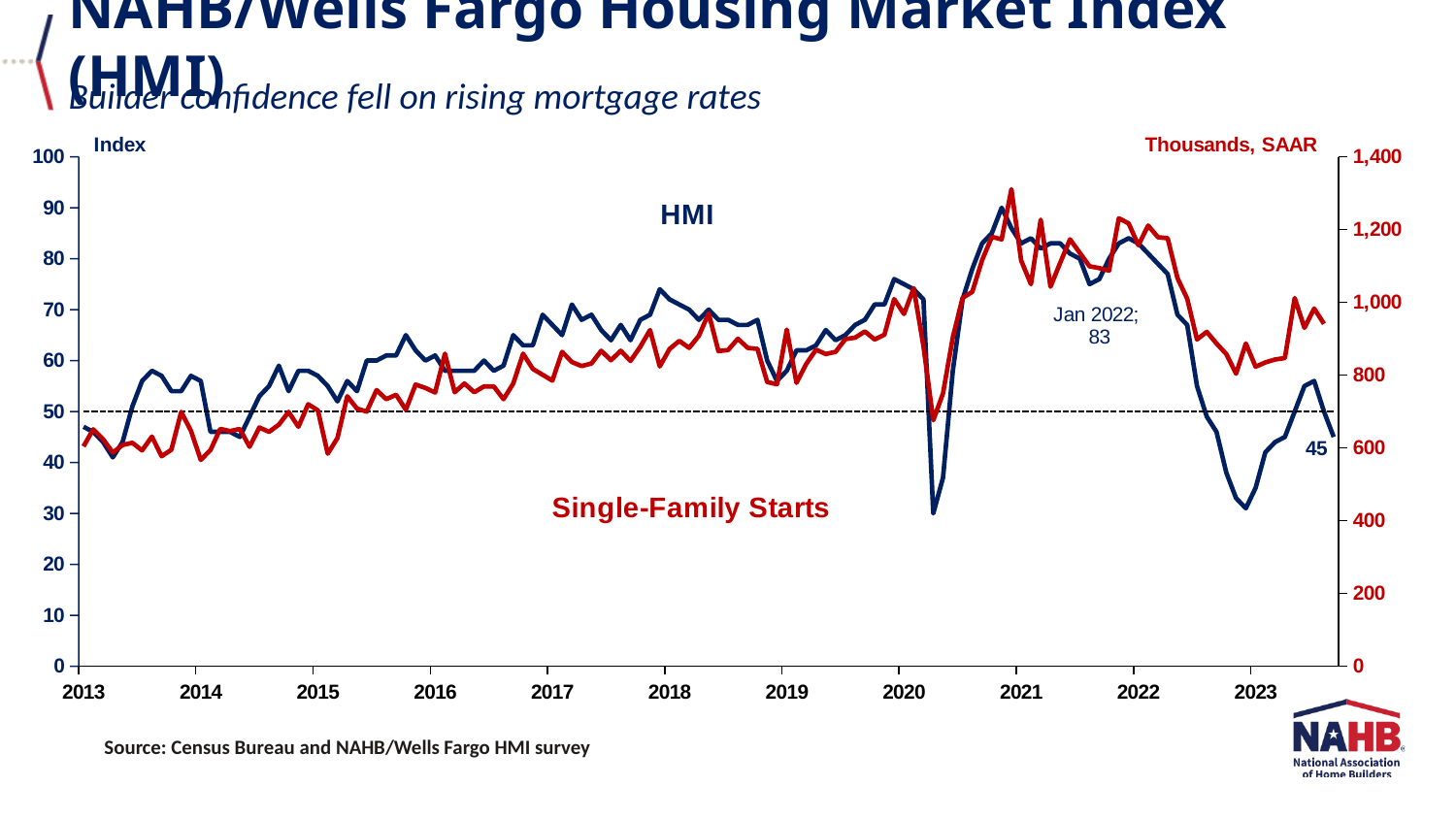
Is the HMI value at the end of the series higher or lower than its value in Jan 2022? lower At what level on the left axis is the dashed horizontal reference line drawn? 50 What kind of chart is shown on the slide? line chart By how many points did the HMI fall from its Jan 2022 value of 83 to the latest value of 45? 38 Is the HMI peak reached in late 2020 greater or less than 80? greater Is the latest HMI value of 45 greater or less than 50? less How many data series are plotted on the chart? 3 Did the HMI rise or fall overall between Jan 2022 and the last point on the chart? fall What is the label on the right-hand vertical axis? Thousands, SAAR What is the most recent HMI value labeled at the end of the navy line? 45 Is the lowest HMI value reached in 2020 greater or less than 40? less What was the HMI value in Jan 2022, as labeled on the chart? 83